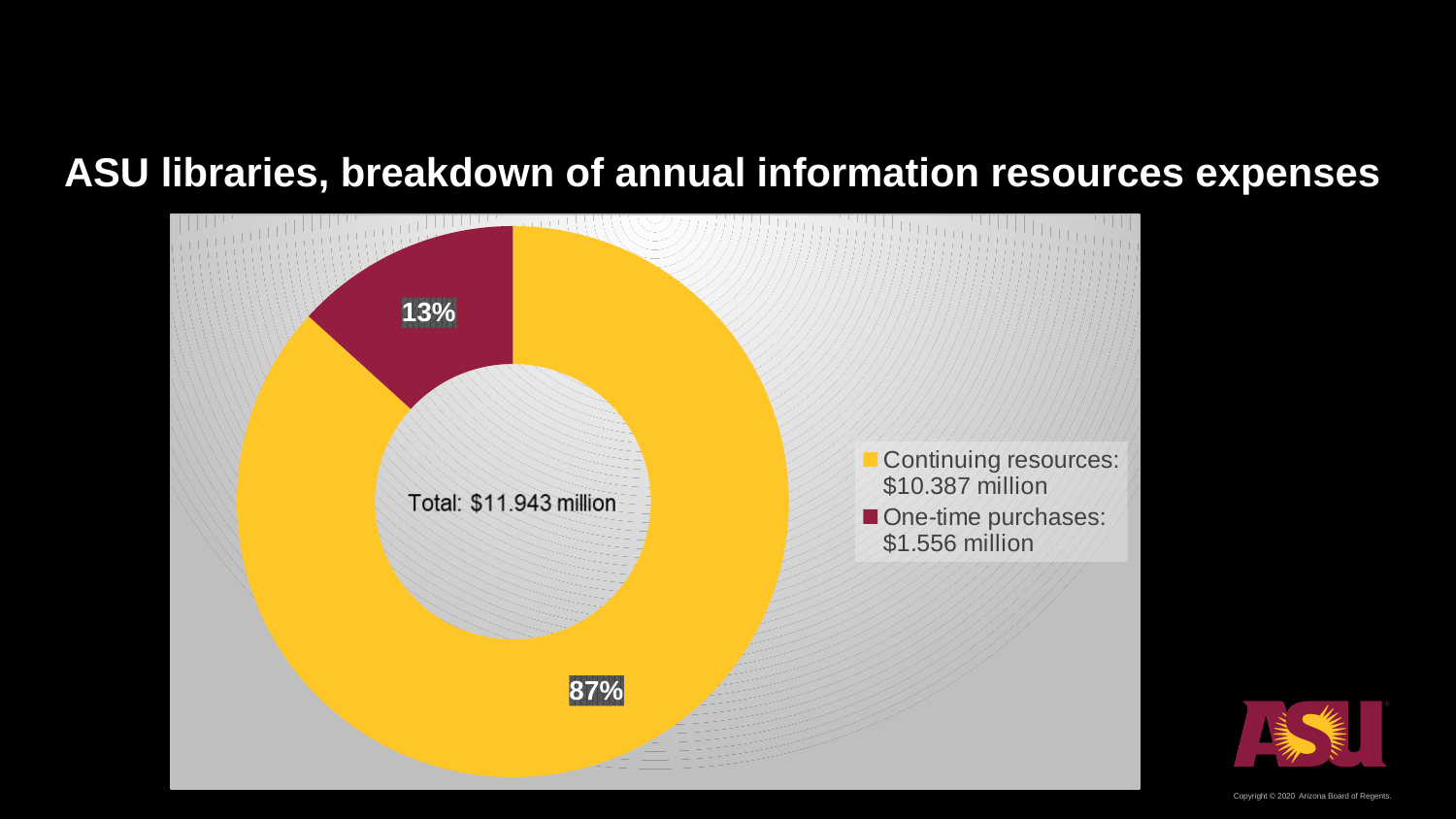
Which is larger, the share for Continuing resources or the share for One-time purchases? Continuing resources Which category accounts for the smallest share of expenses? One-time purchases What is the title of the slide? ASU libraries, breakdown of annual information resources expenses What is the total annual information resources expense shown in the centre of the chart? $11.943 million What kind of chart is shown on the slide? Doughnut (pie) chart What is the dollar value for One-time purchases shown in the legend? $1.556 million What is the dollar value for Continuing resources shown in the legend? $10.387 million What share of annual information resources expenses is Continuing resources? 87% Which category accounts for the largest share of expenses? Continuing resources What is the difference in percentage points between the Continuing resources share and the One-time purchases share? 74 percentage points What share of annual information resources expenses is One-time purchases? 13% How many categories does the chart show? 2